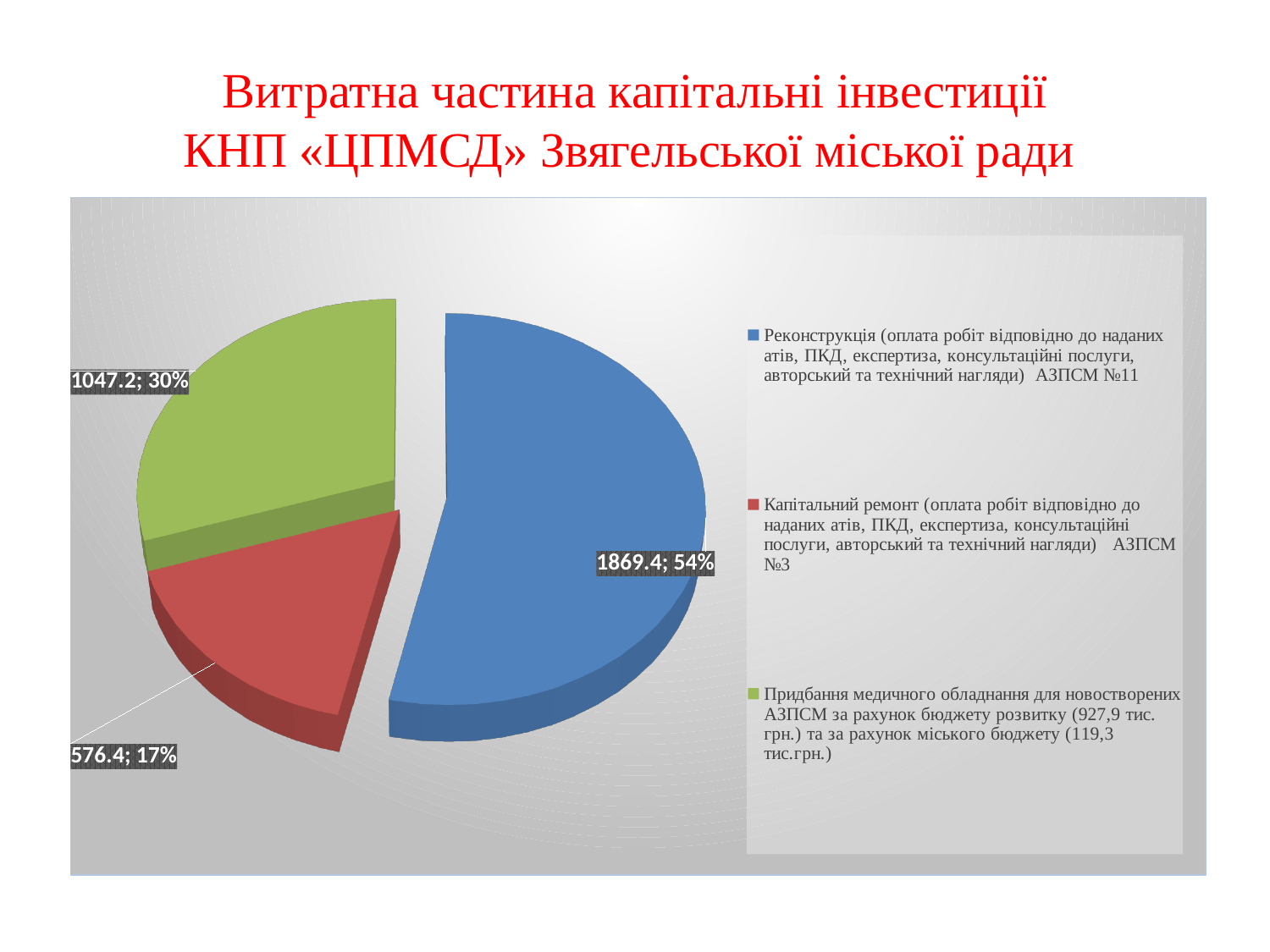
What share of the pie does the Реконструкція (АЗПСМ №11) slice represent? 54% How many slices does the pie chart have? 3 What value is shown for the Придбання медичного обладнання slice? 1047.2 Which category has the smallest slice? Капітальний ремонт (АЗПСМ №3) What value is shown for the Реконструкція (АЗПСМ №11) slice? 1869.4 What share of the pie does the Капітальний ремонт (АЗПСМ №3) slice represent? 17% What value is shown for the Капітальний ремонт (АЗПСМ №3) slice? 576.4 Which category has the largest slice? Реконструкція (АЗПСМ №11) What is the difference between the Реконструкція (АЗПСМ №11) value and the Придбання медичного обладнання value? 822.2 How many entries does the legend list? 3 Which colour represents the Придбання медичного обладнання slice? Green What kind of chart is shown on the slide? Pie chart